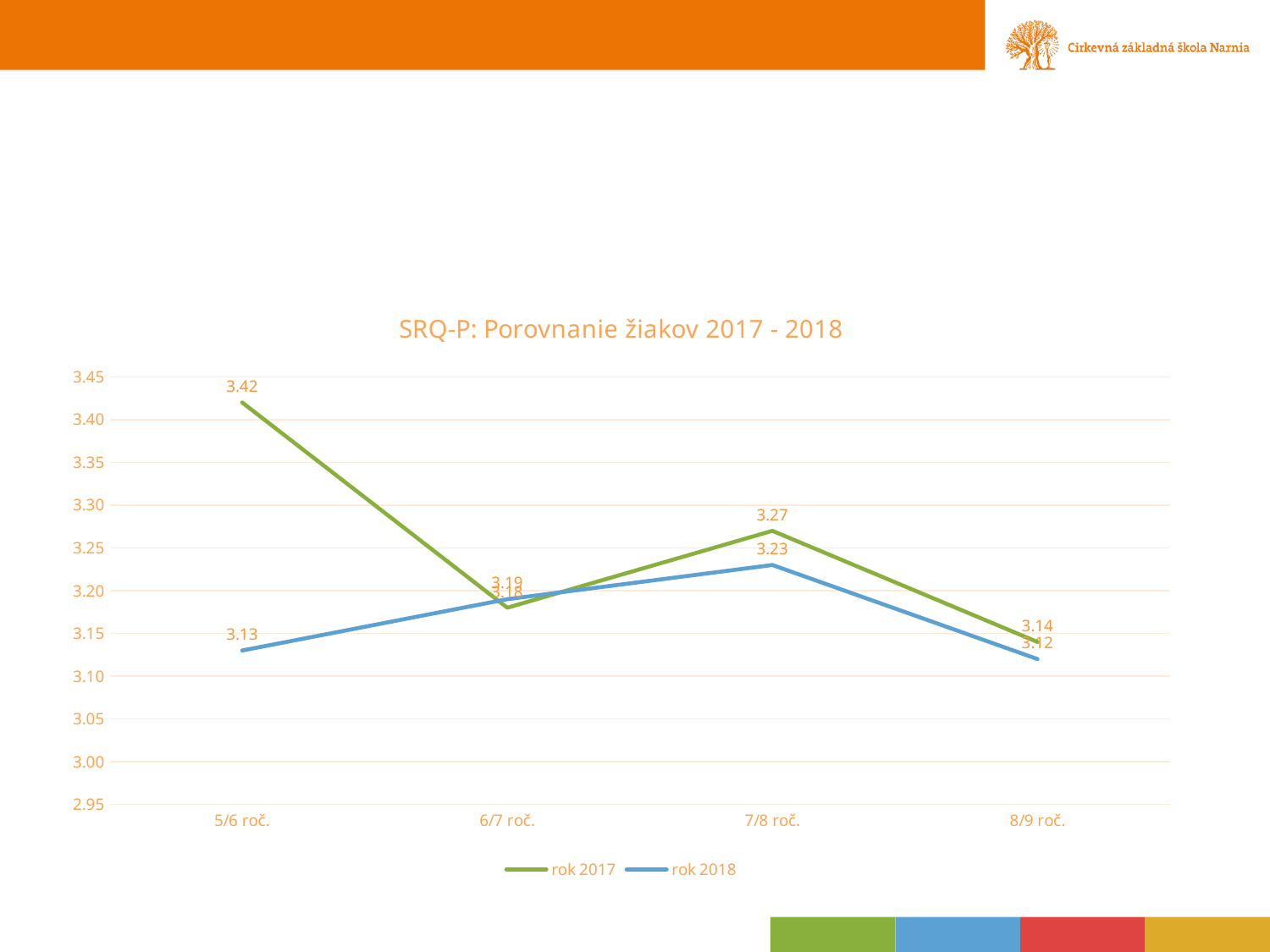
What is the value for rok 2017 at 7/8 roč.? 3.27 How many series does the legend list? 2 Which category has the highest value for rok 2018? 7/8 roč. What is the value for rok 2017 at 5/6 roč.? 3.42 Which category has the highest value for rok 2017? 5/6 roč. What is the value for rok 2018 at 5/6 roč.? 3.13 What is the title of the chart? SRQ-P: Porovnanie žiakov 2017 - 2018 What is the difference between rok 2017 and rok 2018 at 5/6 roč.? 0.29 How many categories are shown on the x axis? 4 What kind of chart is shown on the slide? line chart At 7/8 roč., which series has the larger value, rok 2017 or rok 2018? rok 2017 What is the value for rok 2018 at 7/8 roč.? 3.23